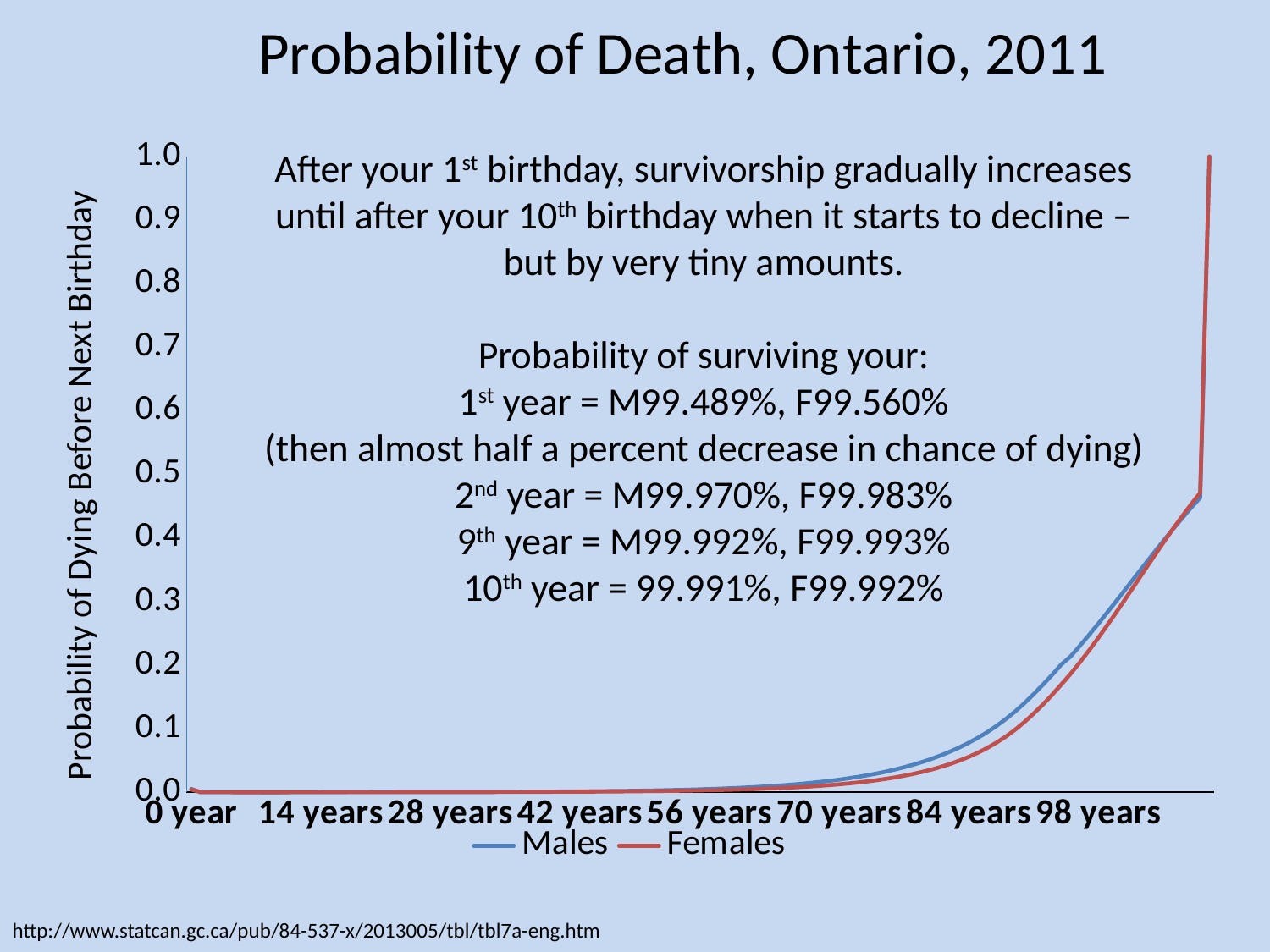
What is the title of the chart? Probability of Death, Ontario, 2011 How many series does the legend list? 2 What are the two series named in the legend? Males and Females What kind of chart is shown on the slide? Line chart Is the value for Females at 70 years greater or less than 0.1? less How many age labels are shown along the x axis? 8 Is the value for Females at 98 years greater or less than 0.5? less Is the value for Males at 70 years greater or less than 0.1? less Do the probability values generally rise or fall as age increases along the x axis? Rise At 84 years, which series has the higher probability of dying, Males or Females? Males